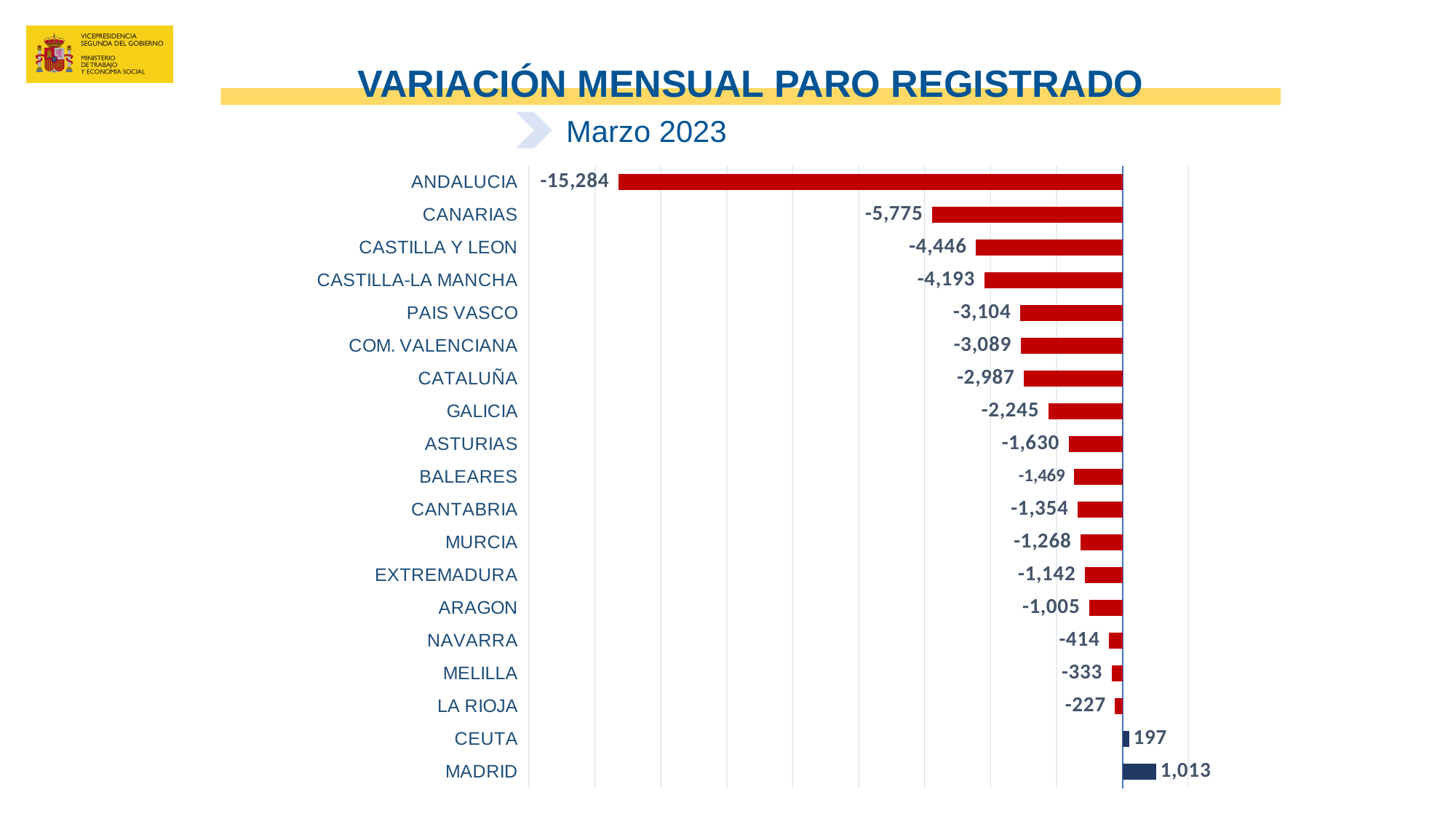
What is the value for NAVARRA? -414 What is the value for CATALUÑA? -2,987 What kind of chart is shown on the slide? Bar chart What is the value for ANDALUCIA? -15,284 What is the difference between the values for MADRID and CEUTA? 816 What is the value for MADRID? 1,013 What month and year does the chart refer to? Marzo 2023 Which region has the highest value? MADRID Which region has the lowest (most negative) value? ANDALUCIA How many regions are shown in the chart? 19 Which has the larger value, CEUTA or LA RIOJA? CEUTA What is the difference between the values for ANDALUCIA and CANARIAS? 9,509